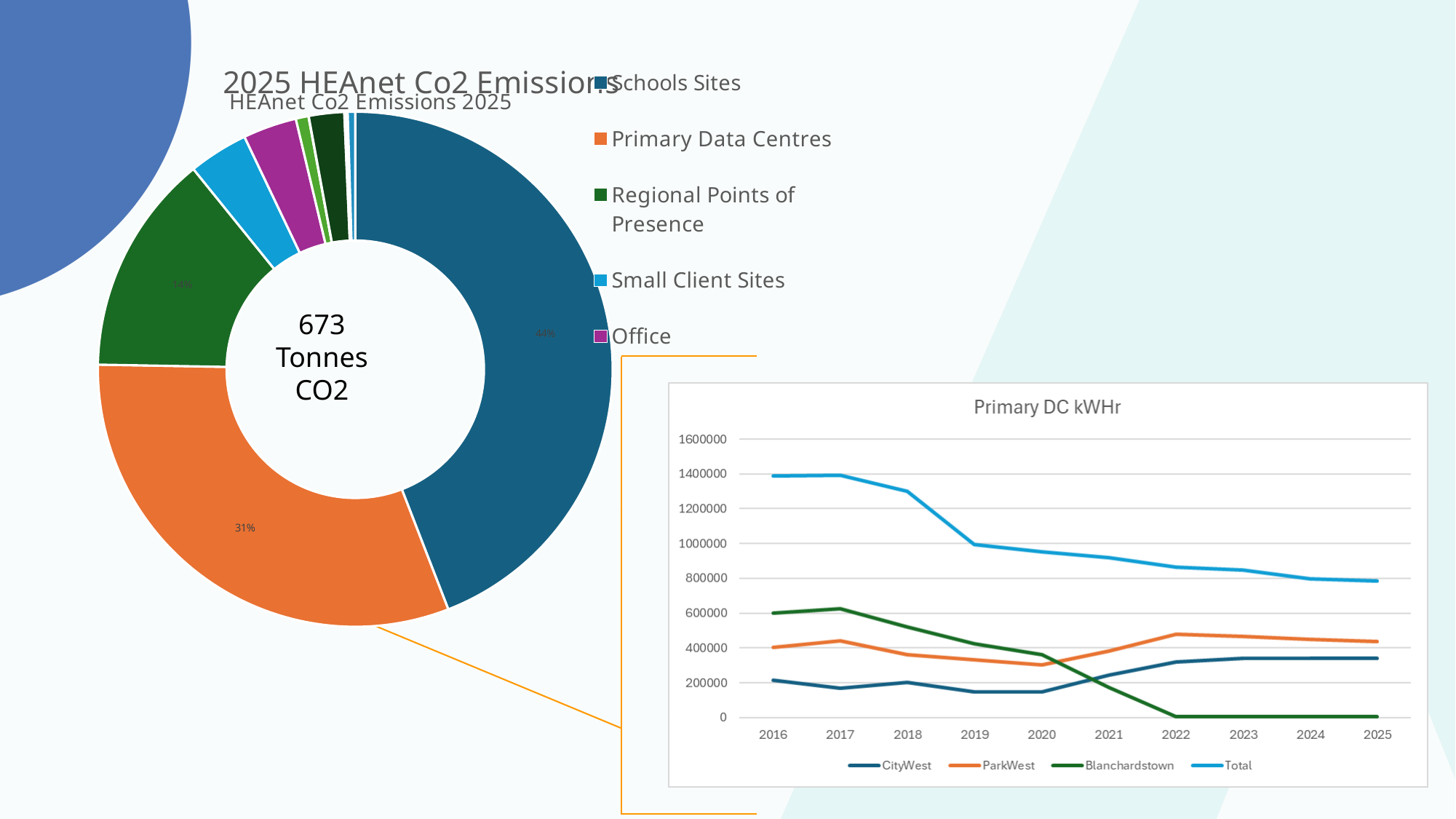
On the HEAnet Co2 Emissions 2025 chart, which category has the largest share? Schools Sites On the HEAnet Co2 Emissions 2025 chart, how many percentage points larger is the Schools Sites share than the Primary Data Centres share? 13 percentage points On the Primary DC kWHr chart, in 2025 which is higher, ParkWest or CityWest? ParkWest On the HEAnet Co2 Emissions 2025 chart, what total figure is printed in the centre of the chart? 673 Tonnes CO2 On the Primary DC kWHr chart, is the Total value for 2016 greater or less than 1200000? greater On the HEAnet Co2 Emissions 2025 chart, what percentage is shown for Primary Data Centres? 31% On the Primary DC kWHr chart, how many years are shown on the x axis? 10 What kind of chart is the HEAnet Co2 Emissions 2025 chart? Doughnut (pie) chart On the HEAnet Co2 Emissions 2025 chart, what percentage is shown for Regional Points of Presence? 14% On the HEAnet Co2 Emissions 2025 chart, what share of emissions comes from Schools Sites? 44% On the Primary DC kWHr chart, does the Total series rise or fall from 2016 to 2025? Fall On the Primary DC kWHr chart, how many series does the legend list? 4